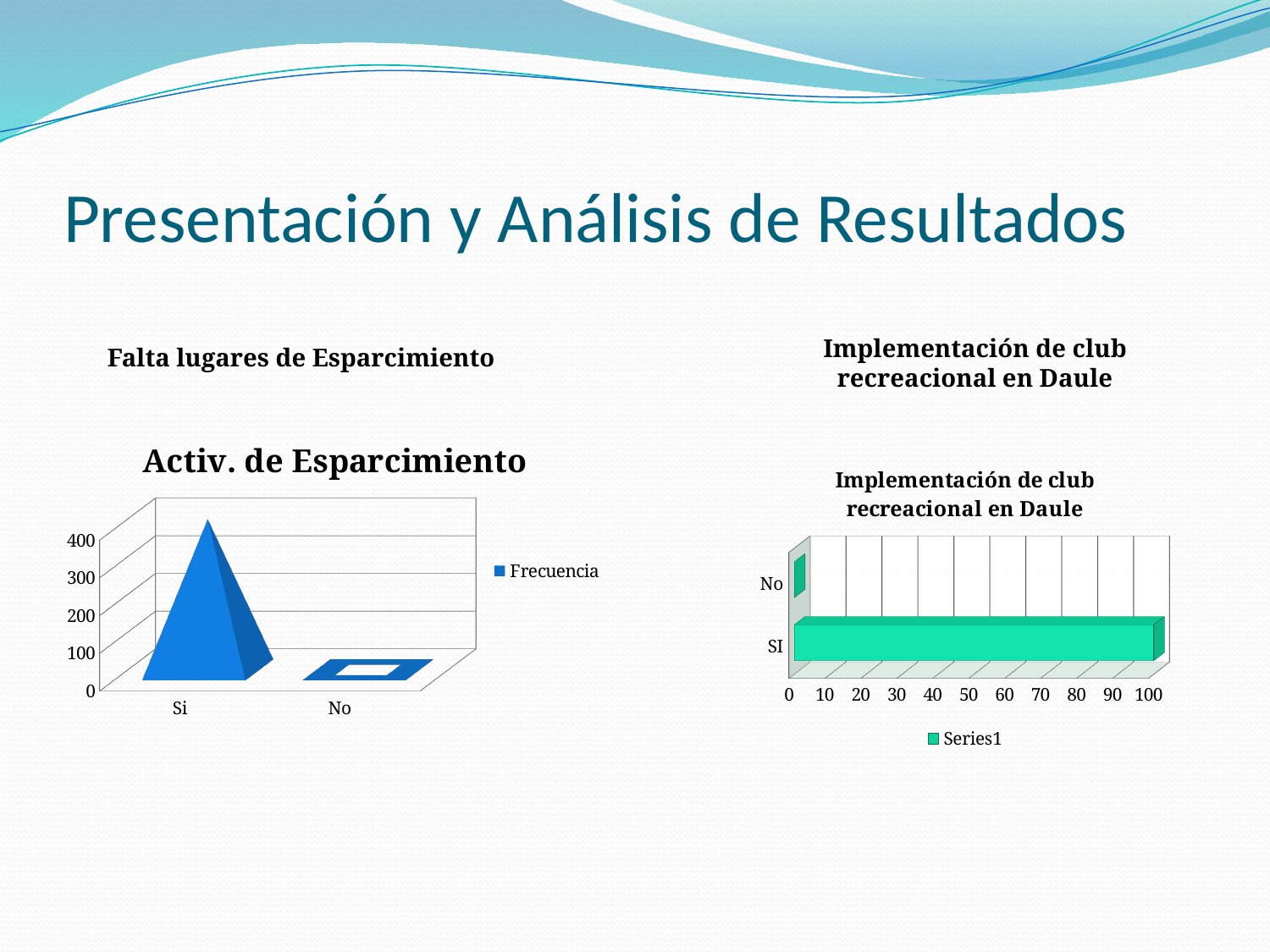
In the chart titled "Activ. de Esparcimiento", how many categories are shown on the x axis? 2 What kind of chart is the one titled "Implementación de club recreacional en Daule"? bar chart In the chart titled "Activ. de Esparcimiento", what series name does the legend show? Frecuencia In the chart titled "Activ. de Esparcimiento", is the value for Si greater or less than 300? greater In the chart titled "Activ. de Esparcimiento", is the value for No greater or less than 100? less In the chart titled "Implementación de club recreacional en Daule", which is larger, the value for SI or the value for No? SI In the chart titled "Implementación de club recreacional en Daule", which category has the highest value? SI In the chart titled "Implementación de club recreacional en Daule", is the value for No greater or less than 10? less In the chart titled "Activ. de Esparcimiento", which category has the lowest value? No In the chart titled "Activ. de Esparcimiento", which category has the highest value? Si In the chart titled "Implementación de club recreacional en Daule", how many series does the legend list? 1